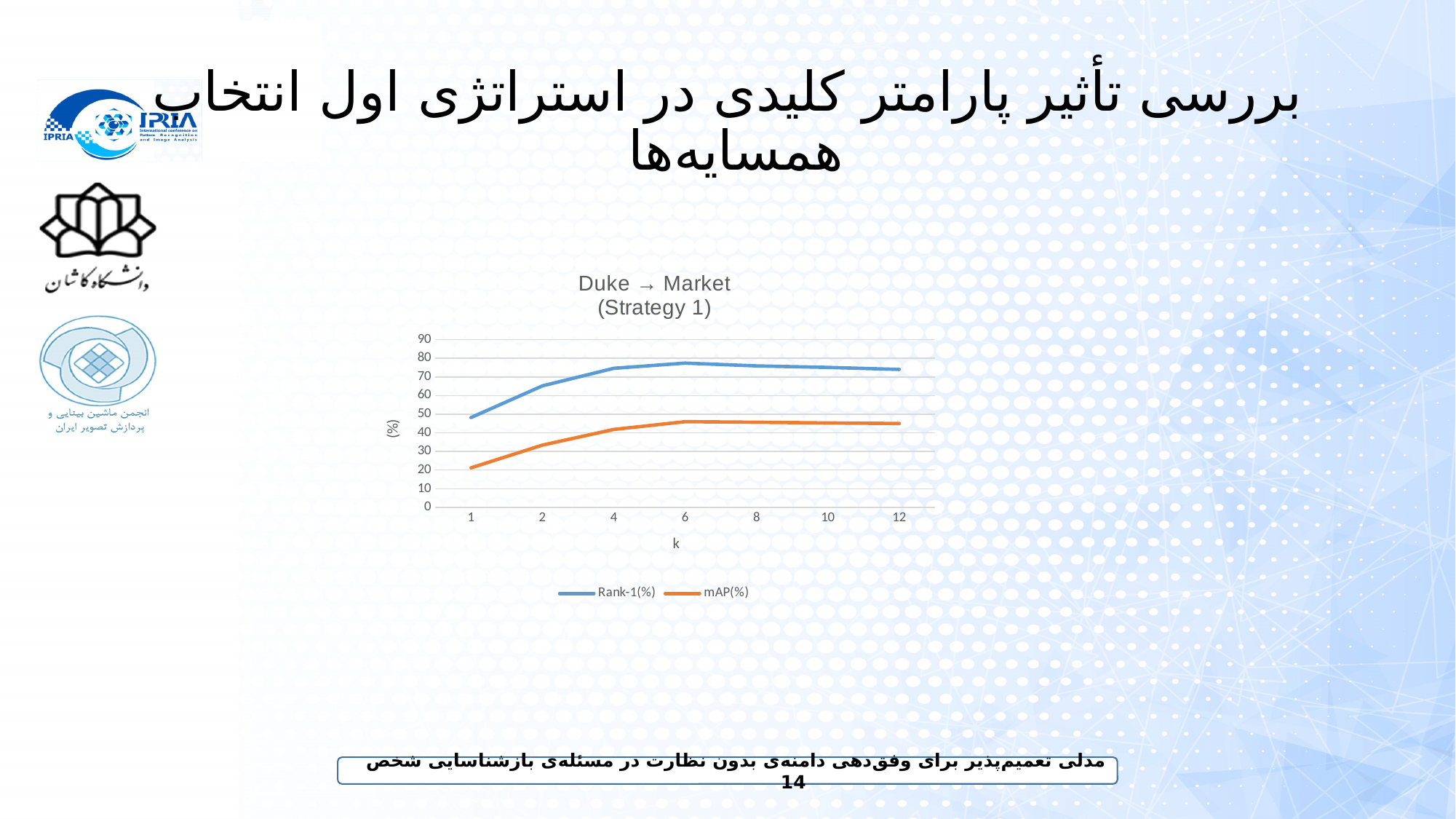
Is the Rank-1(%) value at k=1 greater or less than 60? less How many k values are plotted along the x axis? 7 Which series is drawn in orange? mAP(%) Is the mAP(%) value at k=12 greater or less than 50? less Is the mAP(%) value at k=1 greater or less than 30? less How many series does the legend list? 2 At which k value is Rank-1(%) lowest? 1 At k=4, which series has the larger value, Rank-1(%) or mAP(%)? Rank-1(%) Does the mAP(%) line rise or fall from k=1 to k=6? rise What kind of chart is shown on the slide? line chart What is the title of the chart? Duke → Market (Strategy 1)